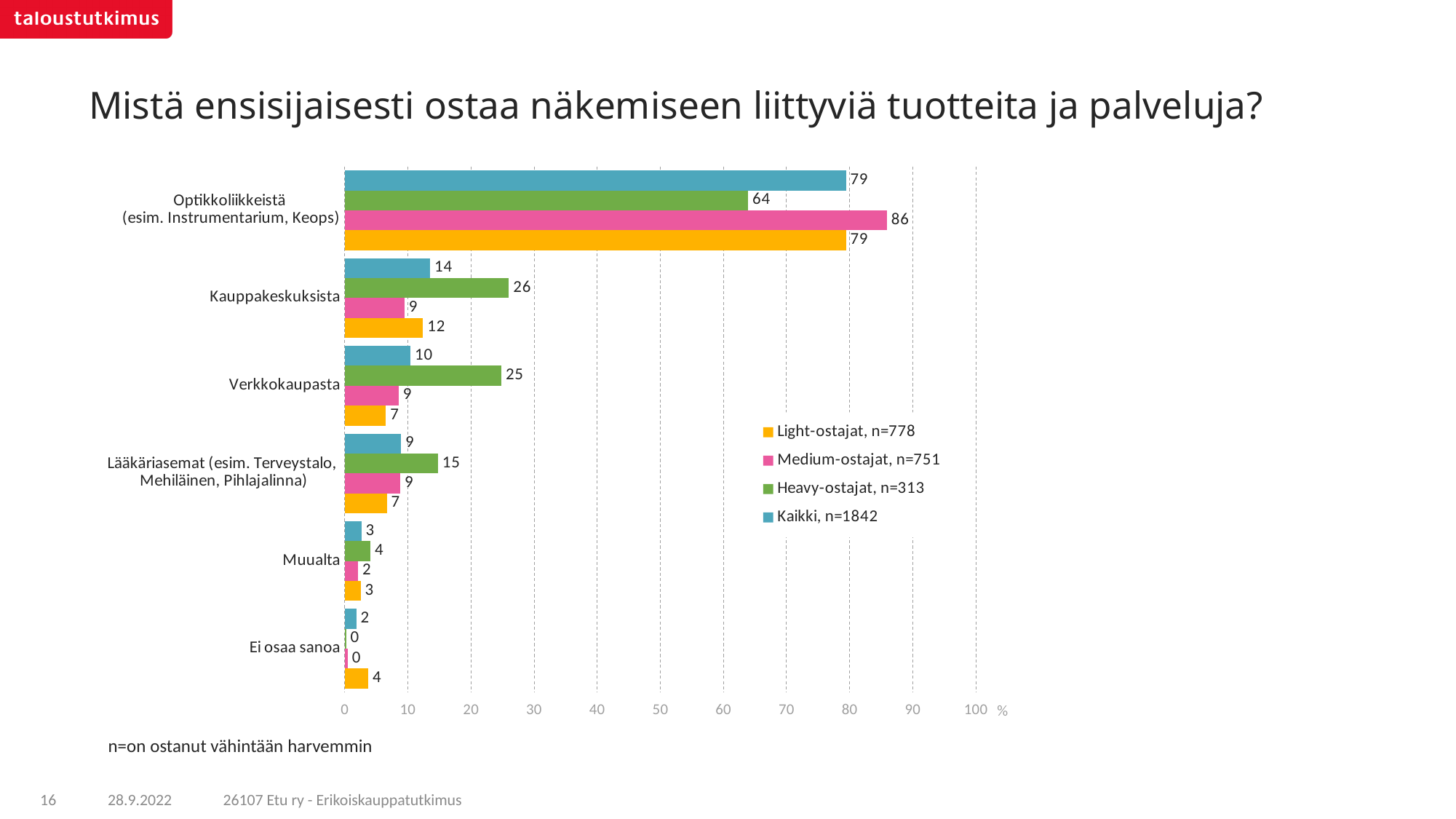
In the Verkkokaupasta category, which series has the larger value: Heavy-ostajat, n=313 or Light-ostajat, n=778? Heavy-ostajat, n=313 What is the value for Kaikki, n=1842 in the Verkkokaupasta category? 10 What is the value for Heavy-ostajat, n=313 in the Kauppakeskuksista category? 26 What is the difference between the Medium-ostajat, n=751 and Heavy-ostajat, n=313 values in the Optikkoliikkeistä (esim. Instrumentarium, Keops) category? 22 What kind of chart is shown on the slide? Bar chart What is the value for Medium-ostajat, n=751 in the Optikkoliikkeistä (esim. Instrumentarium, Keops) category? 86 Which colour represents Kaikki, n=1842 in the legend? Blue How many series does the legend list? 4 How many categories are shown on the chart? 6 Which category has the lowest value for Heavy-ostajat, n=313? Ei osaa sanoa Which category has the highest value for Kaikki, n=1842? Optikkoliikkeistä (esim. Instrumentarium, Keops) What is the value for Light-ostajat, n=778 in the Ei osaa sanoa category? 4